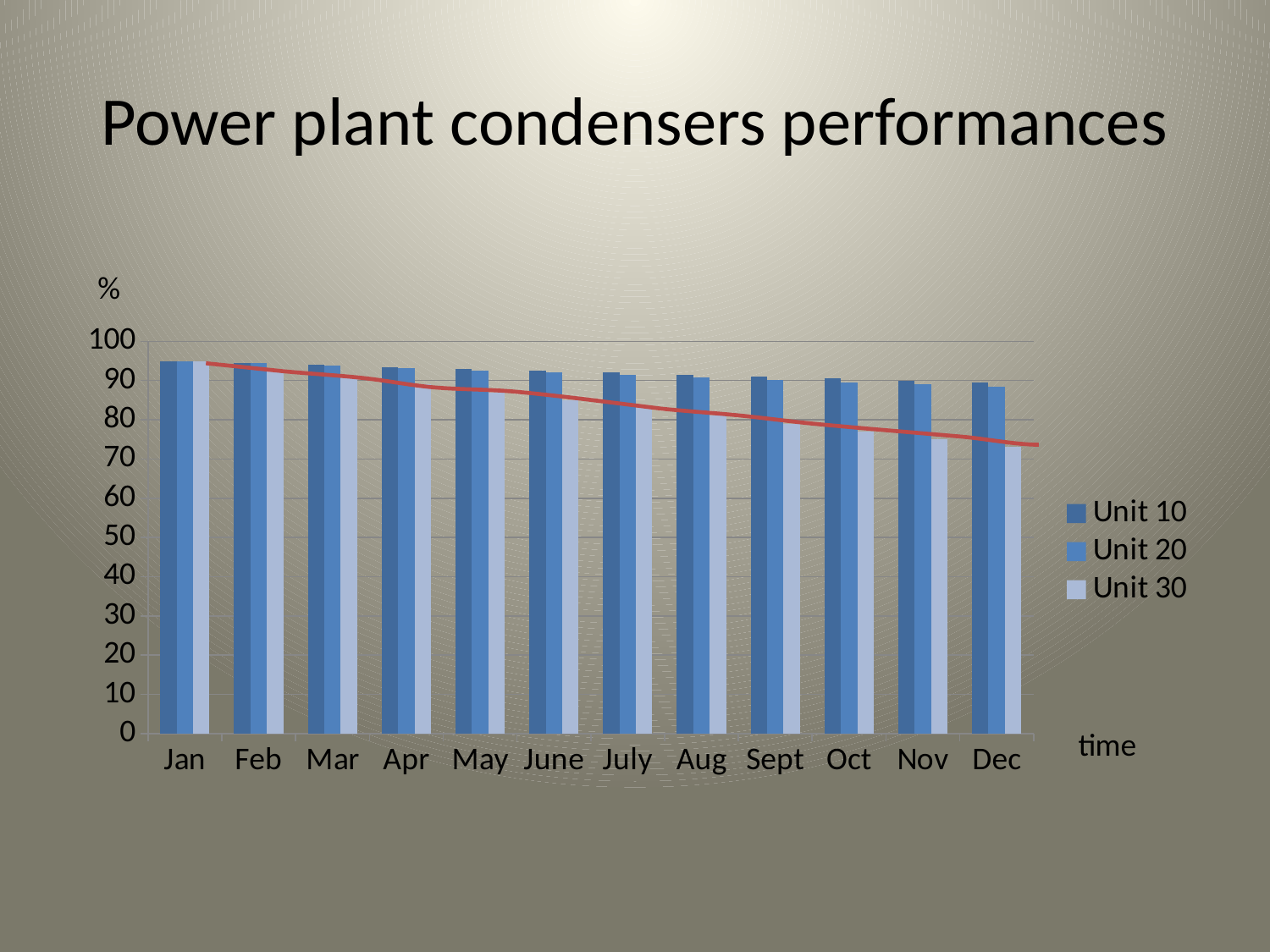
Which is larger for Unit 30: the value in Jan or the value in Dec? Jan What label is shown on the vertical axis? % What is the title of the chart? Power plant condensers performances How many months are shown along the x axis? 12 Is the value for Unit 30 in Dec greater or less than 80? less Is the value for Unit 10 in Dec greater or less than 80? greater In which month is the value for Unit 30 lowest? Dec How many series does the legend list? 3 What kind of chart is shown on the slide? bar chart Is the value for Unit 30 in June greater or less than 80? greater Do the values for Unit 30 rise or fall from Jan to Dec? fall